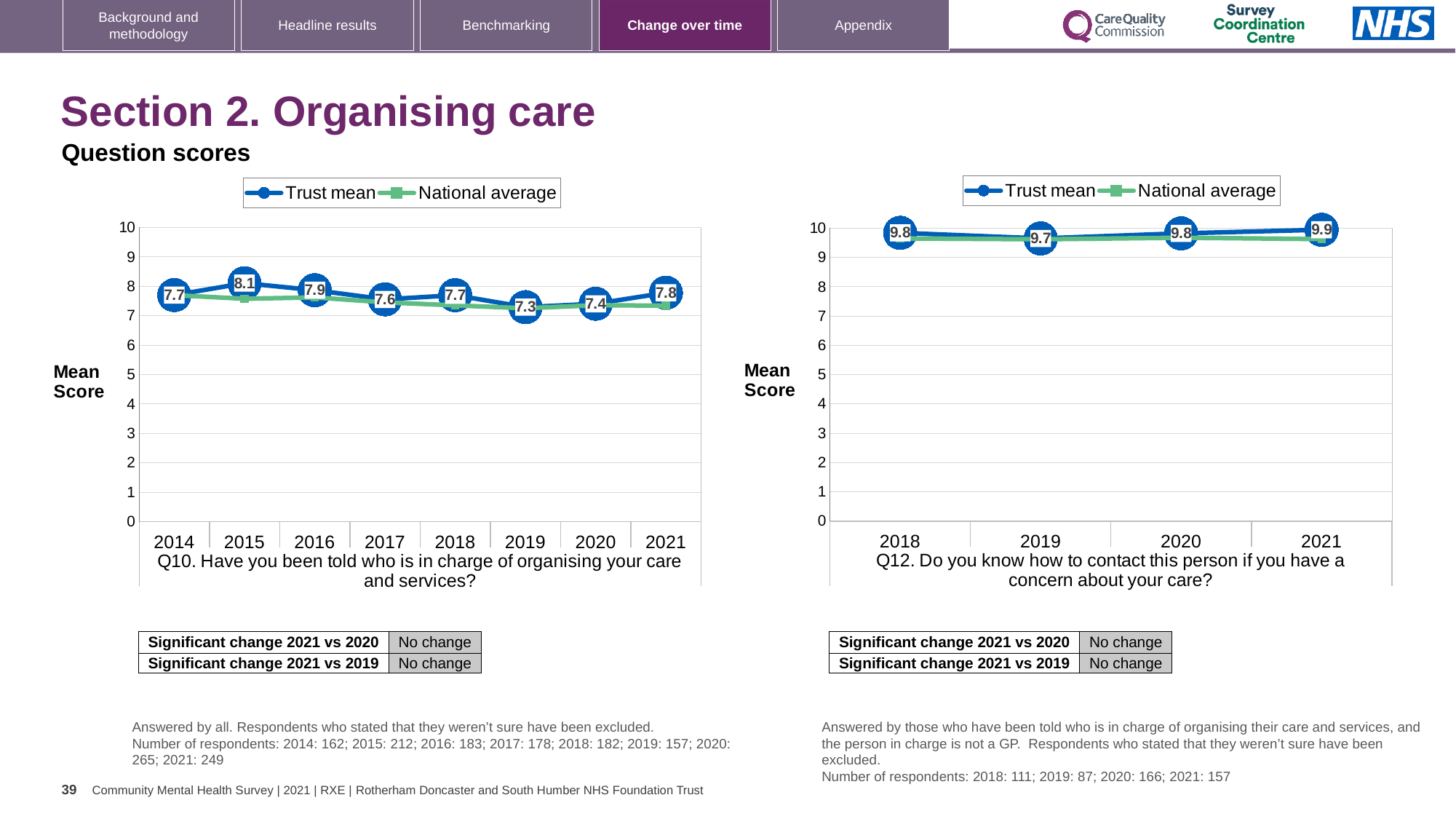
On the Q12 chart (right), which year has the lowest Trust mean score? 2019 On the Q12 chart (right), how many series does the legend list? 2 On the Q10 chart (left), which year has the lowest Trust mean score? 2019 On the Q12 chart (right), what is the Trust mean score for 2021? 9.9 On the Q12 chart (right), is the Trust mean score for 2020 greater or less than 9? greater On the Q10 chart (left), what is the Trust mean score for 2019? 7.3 What kind of chart is the Q10 chart on the left? Line chart On the Q10 chart (left), which year has the highest Trust mean score? 2015 On the Q10 chart (left), which series is shown in green in the legend? National average On the Q10 chart (left), what is the difference between the Trust mean scores for 2015 and 2019? 0.8 On the Q10 chart (left), what is the Trust mean score for 2015? 8.1 On the Q10 chart (left), how many years are plotted on the x axis? 8